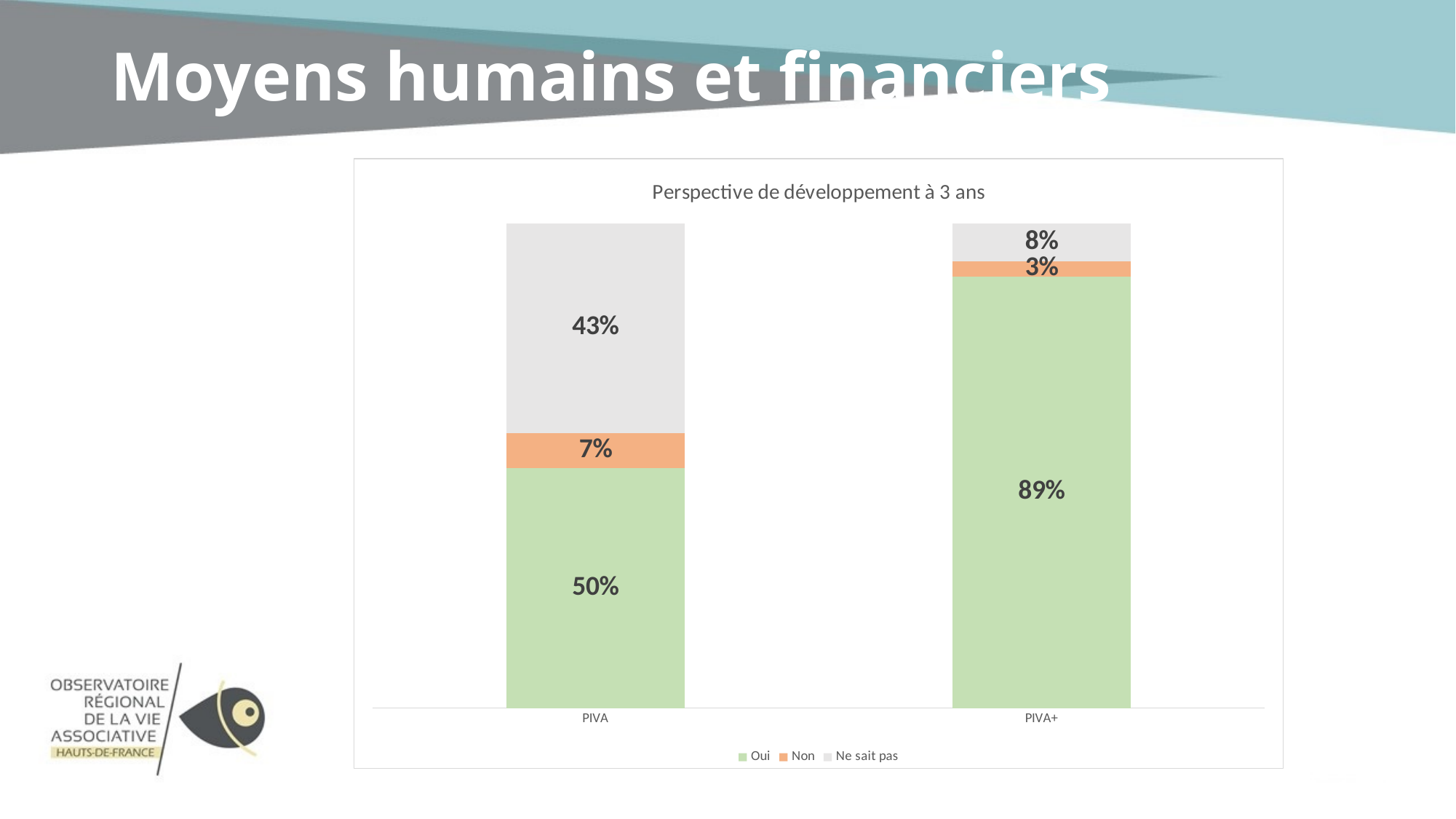
What kind of chart is shown on the slide? Stacked bar chart What is the value for "Non" for PIVA? 7% What is the difference between the "Ne sait pas" values for PIVA and PIVA+? 35% What is the value for "Oui" for PIVA+? 89% How many series does the legend list? 3 Which category has the lowest "Non" value? PIVA+ What is the value for "Ne sait pas" for PIVA+? 8% How many categories are shown on the x axis? 2 What is the difference between the "Oui" values for PIVA+ and PIVA? 39% Which category has the higher "Oui" value, PIVA or PIVA+? PIVA+ What is the value for "Oui" for PIVA? 50% What is the title of the chart? Perspective de développement à 3 ans